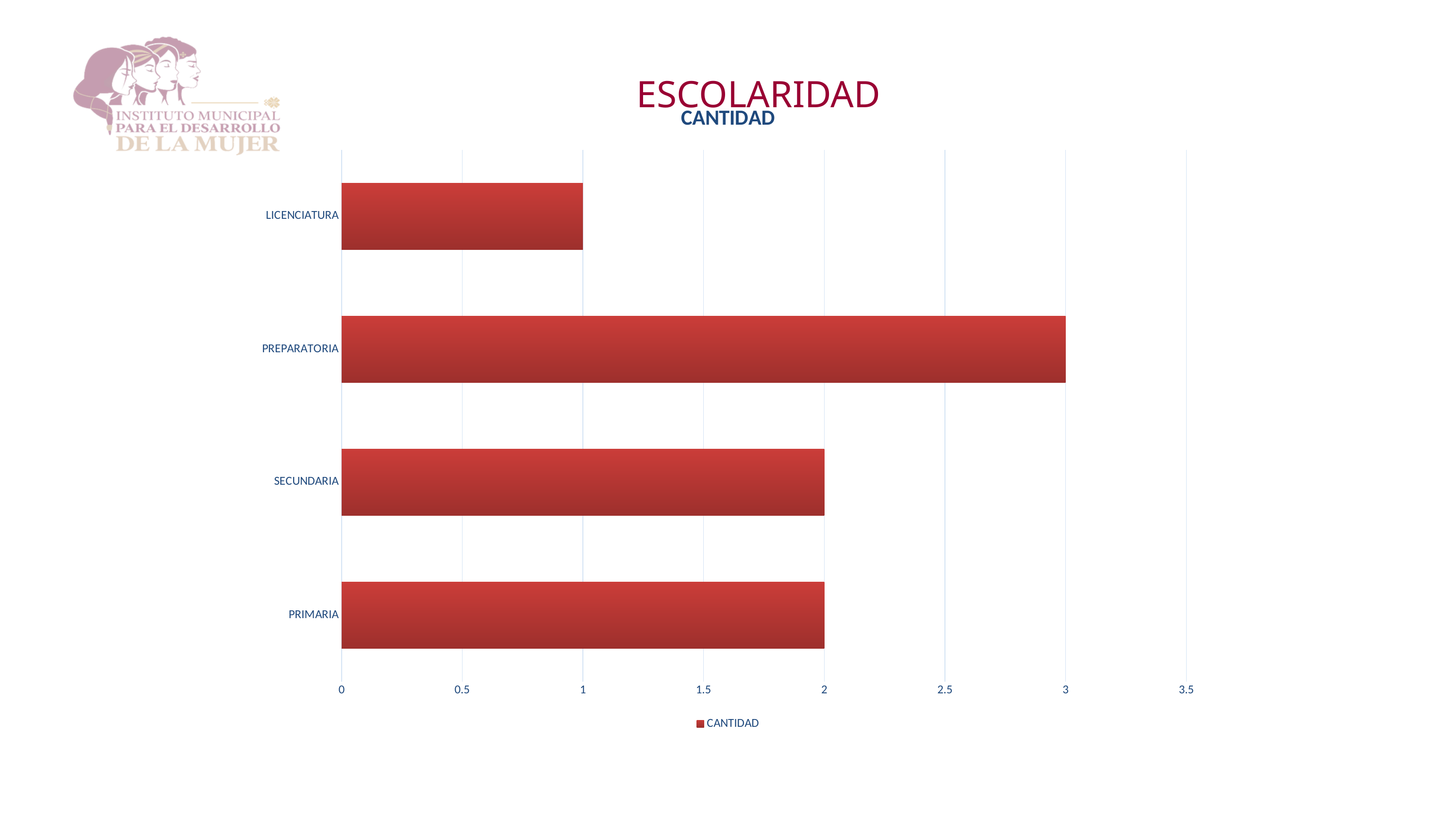
What is the value for SECUNDARIA? 2 How many series does the legend list? 1 What is the value for LICENCIATURA? 1 Which category has the highest value? PREPARATORIA What kind of chart is shown on the slide? Bar chart Which is larger, the value for SECUNDARIA or the value for LICENCIATURA? SECUNDARIA What is the difference between the values for PREPARATORIA and LICENCIATURA? 2 What is the name of the series shown in the legend? CANTIDAD How many categories are shown in the chart? 4 Which category has the lowest value? LICENCIATURA What is the value for PRIMARIA? 2 What is the value for PREPARATORIA? 3